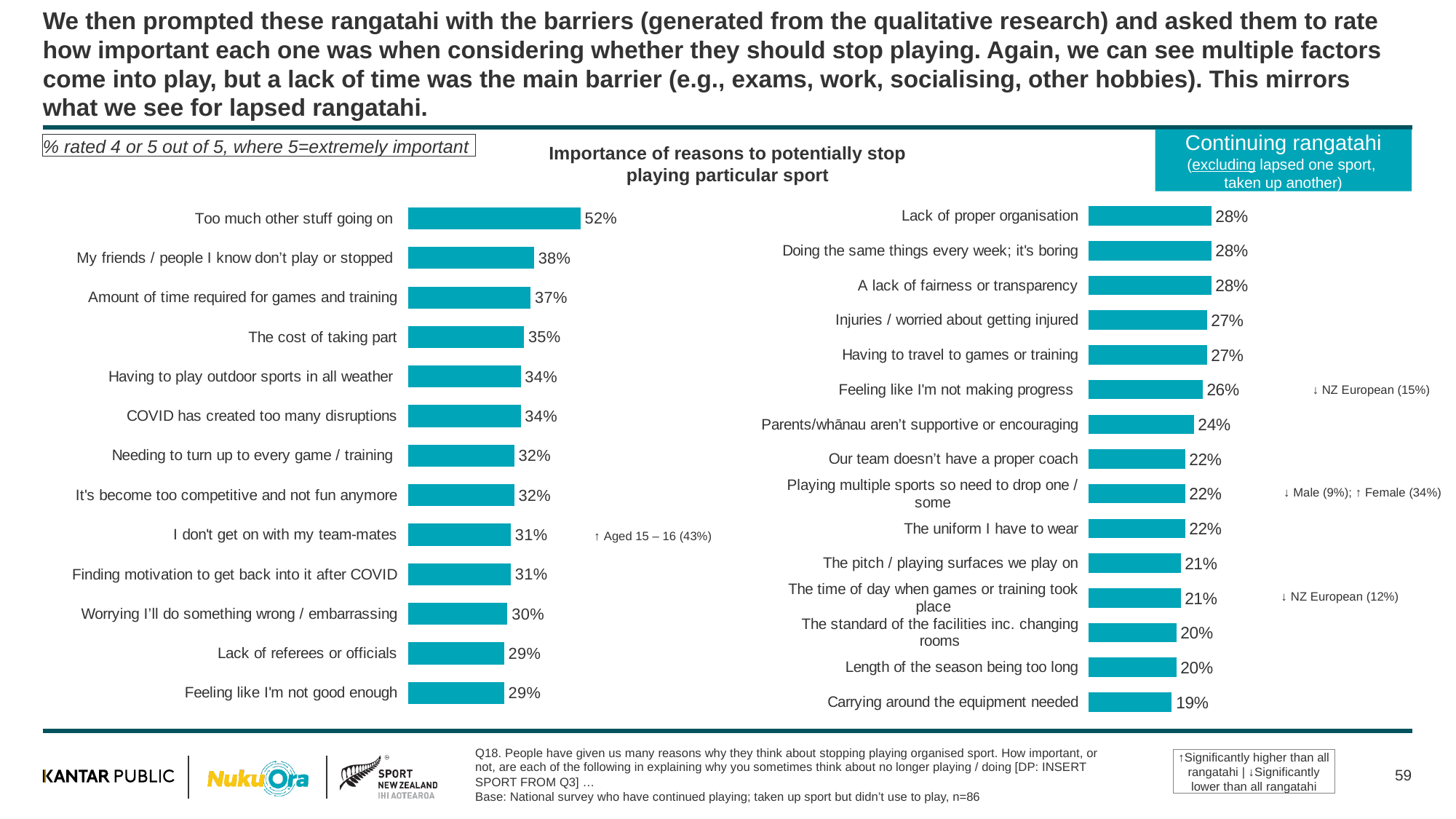
On the left chart, which reason has the highest percentage? Too much other stuff going on On the left chart, what is the difference between 'Too much other stuff going on' and 'My friends / people I know don't play or stopped'? 14 percentage points How many reasons are listed on the right chart? 15 What type of chart is used on this slide? Bar chart On the left chart, what percentage rated 'Too much other stuff going on' as important? 52% On the right chart, what is the difference between 'Feeling like I'm not making progress' and 'Length of the season being too long'? 6 percentage points On the right chart, which reason has the lowest percentage? Carrying around the equipment needed What is the title of the chart on this slide? Importance of reasons to potentially stop playing particular sport How many reasons are listed on the left chart? 13 On the right chart, which is larger: 'Lack of proper organisation' or 'Our team doesn't have a proper coach'? Lack of proper organisation On the left chart, what is the value for 'The cost of taking part'? 35% On the right chart, what is the value for 'Carrying around the equipment needed'? 19%